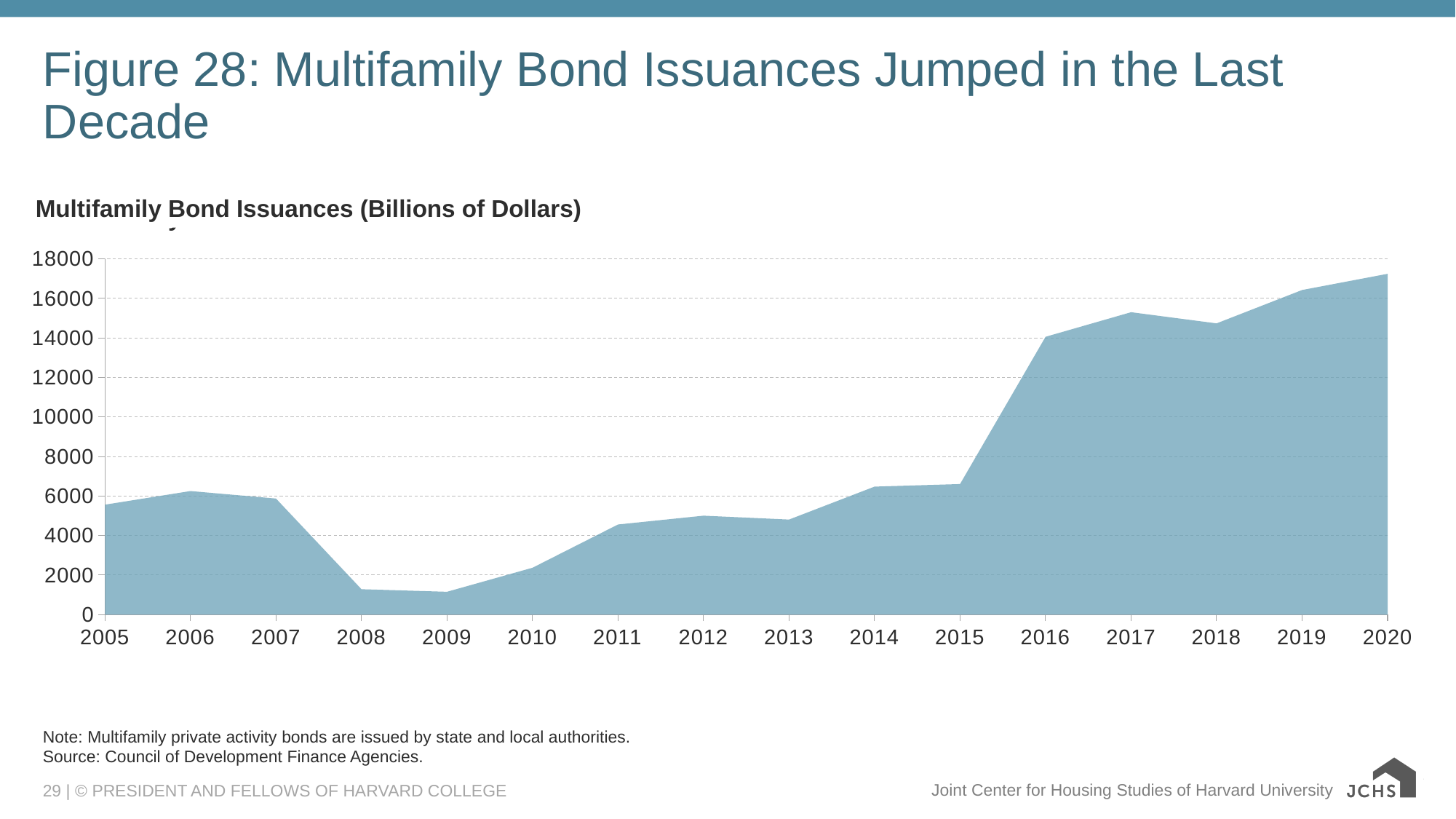
Is the value for 2020 greater or less than 16000? greater Which year has the larger value, 2006 or 2008? 2006 Which year has the highest multifamily bond issuance value? 2020 Is the value for 2010 greater or less than 4000? less How many years are plotted along the x axis? 16 What kind of chart is shown on the slide? Area chart What is the highest value shown on the y axis? 18000 Is the value for 2016 greater or less than 12000? greater Which year has the larger value, 2015 or 2016? 2016 Do the values rise or fall from 2007 to 2009? fall